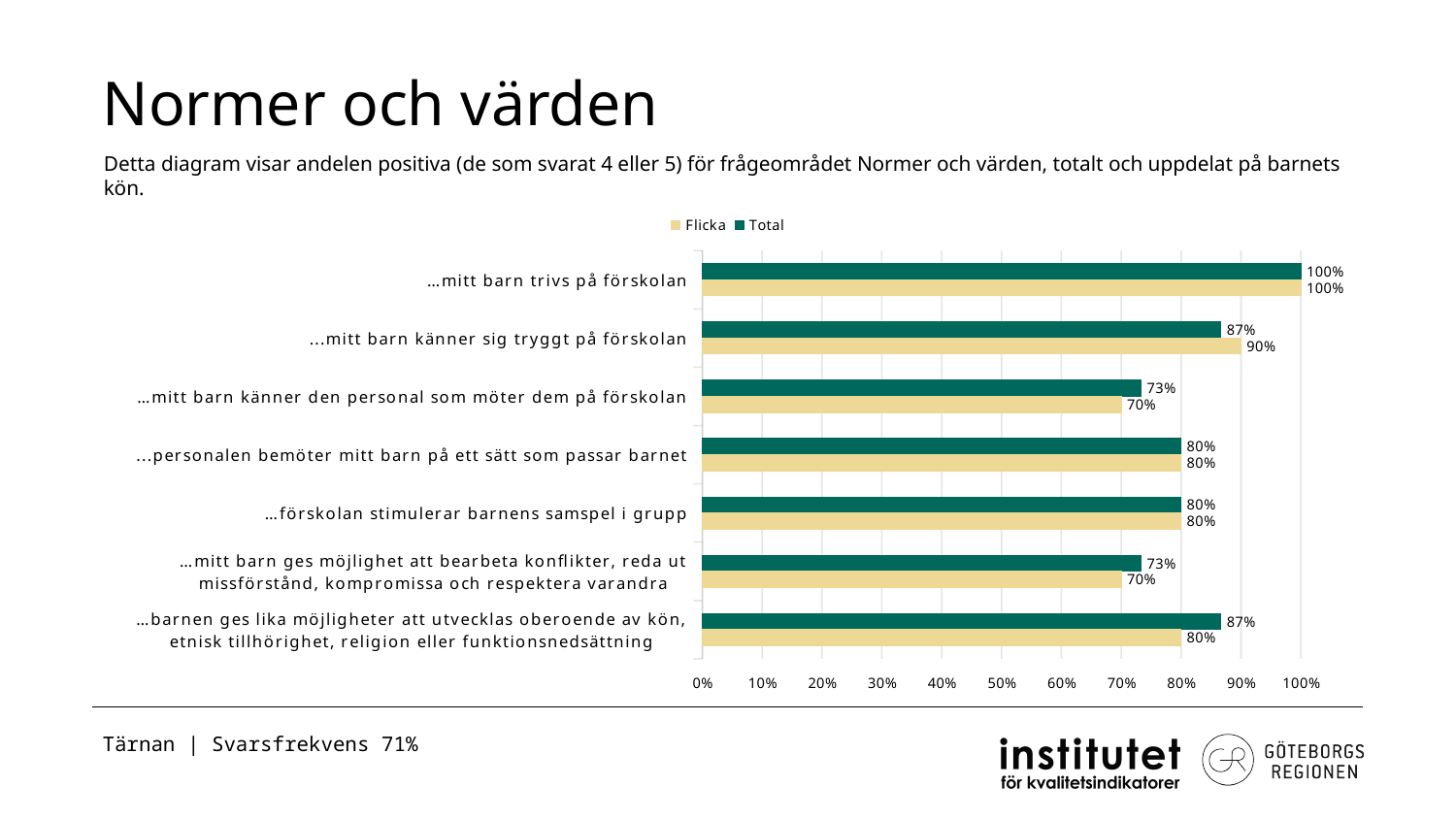
Which colour represents the Total series in the chart? green What is the Total value for "…barnen ges lika möjligheter att utvecklas oberoende av kön, etnisk tillhörighet, religion eller funktionsnedsättning"? 87% What is the Flicka value for "...mitt barn känner sig tryggt på förskolan"? 90% What is the difference between the Total and Flicka values for "…barnen ges lika möjligheter att utvecklas oberoende av kön, etnisk tillhörighet, religion eller funktionsnedsättning"? 7% What type of chart is shown on the slide? bar chart Which category has the highest Total value? …mitt barn trivs på förskolan What is the Flicka value for "…mitt barn känner den personal som möter dem på förskolan"? 70% What is the Total value for "…mitt barn trivs på förskolan"? 100% For "...mitt barn känner sig tryggt på förskolan", which is larger, the Flicka value or the Total value? Flicka How many categories are plotted in the chart? 7 What is the difference between the Total values for "…mitt barn trivs på förskolan" and "…förskolan stimulerar barnens samspel i grupp"? 20% How many series does the legend list? 2